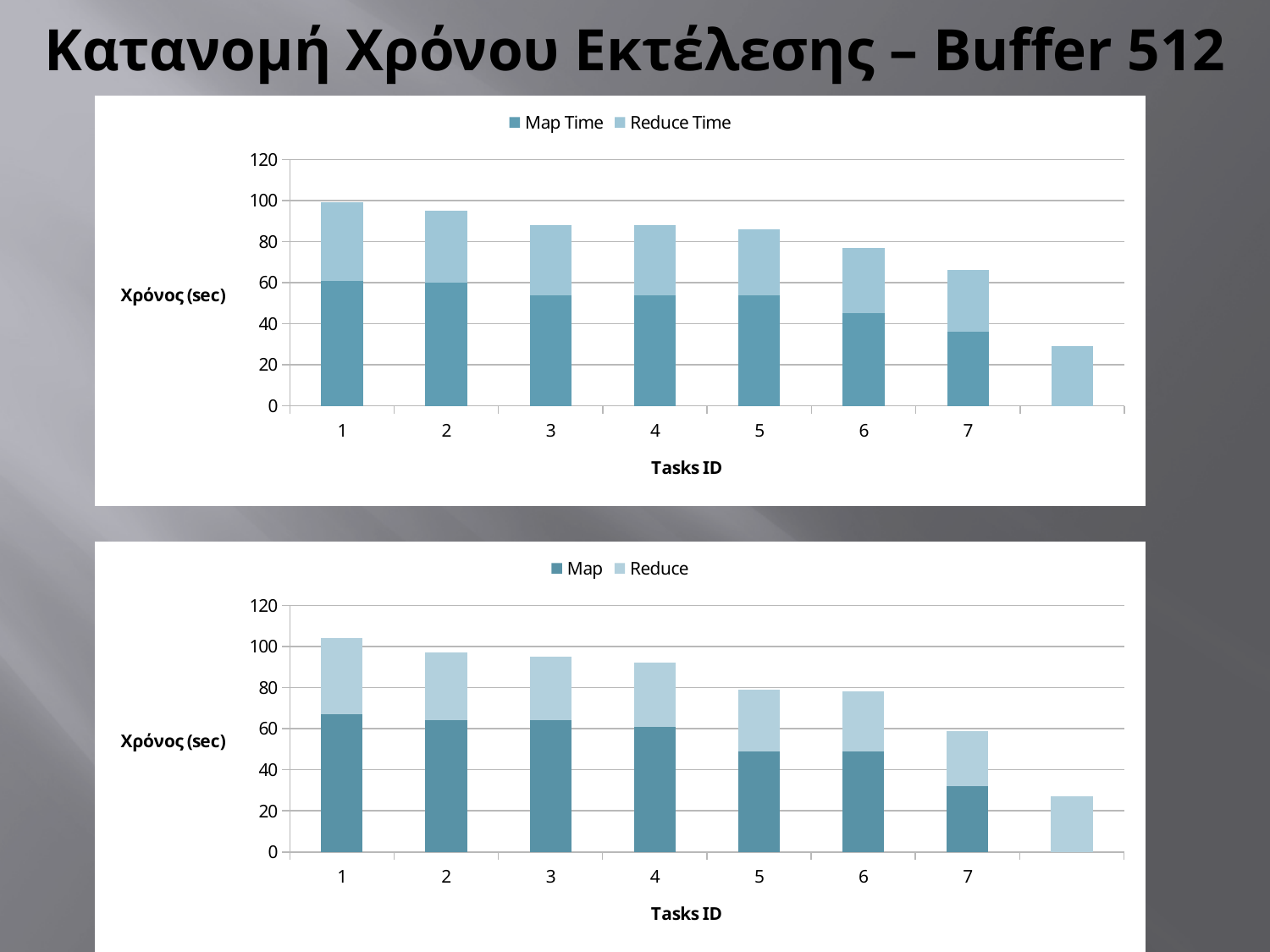
In the top chart, which total bar is taller, Task ID 2 or Task ID 6? Task ID 2 What is the y-axis label of the top chart? Χρόνος (sec) In the bottom chart, is the total bar for Task ID 1 greater or less than 100? greater How many series does the legend of the top chart list? 2 In the bottom chart, is the Map portion for Task ID 1 greater or less than 60? greater What are the two legend entries of the bottom chart? Map and Reduce In the top chart, which Task ID has the tallest total bar? 1 What kind of chart is the top chart on the slide? stacked bar chart In the top chart, is the total bar for Task ID 6 greater or less than 80? less In the bottom chart, do the total bar heights generally rise or fall as the Task ID increases? fall In the bottom chart, which Task ID has the tallest total bar? 1